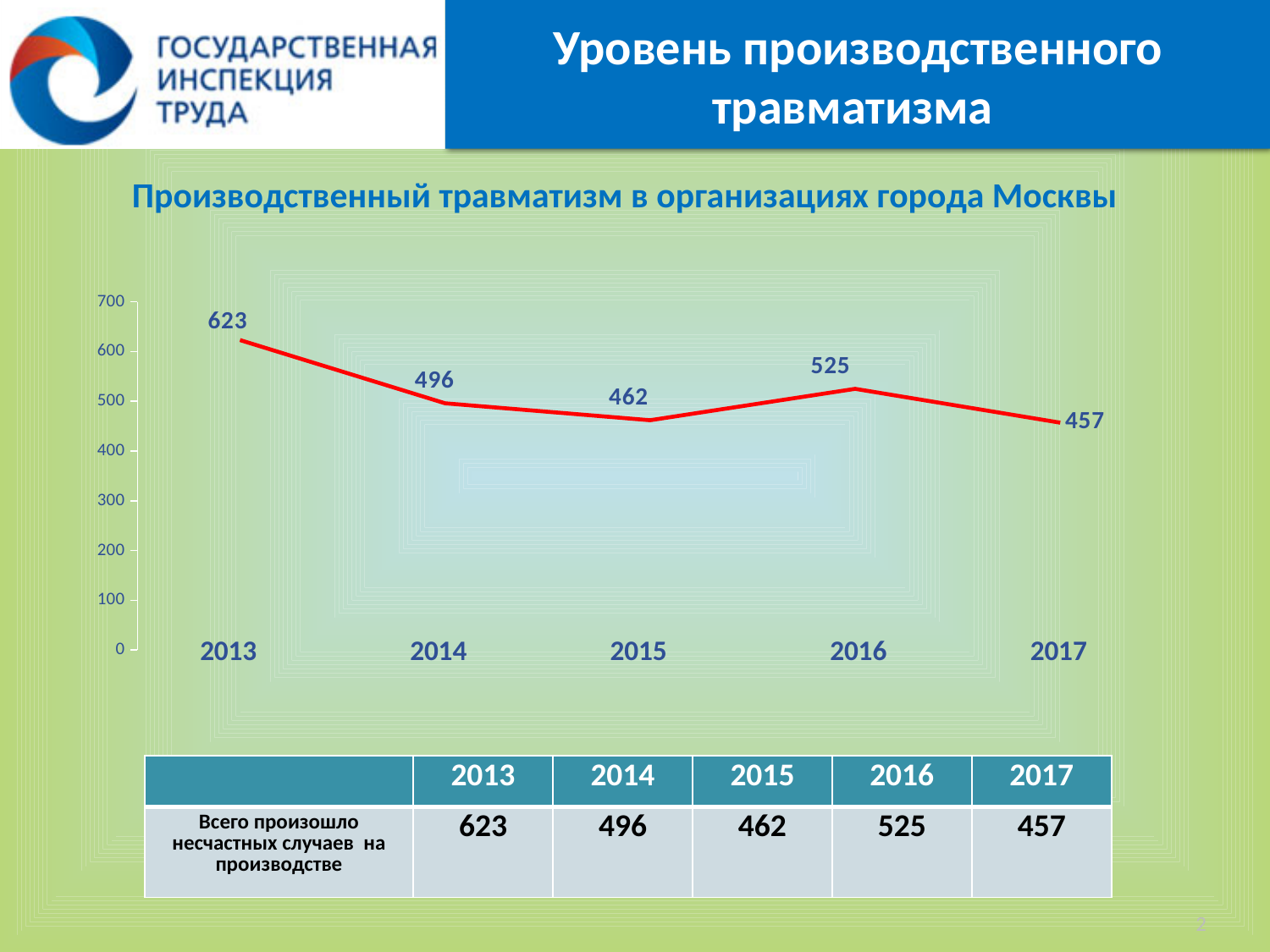
What is the value for 2017? 457 What is the difference between the values for 2016 and 2017? 68 What is the title of the chart? Производственный травматизм в организациях города Москвы What is the value for 2013? 623 What kind of chart is shown? line chart Which year has the highest value? 2013 What is the difference between the values for 2013 and 2014? 127 Which year has the lowest value? 2017 How many years are plotted on the chart? 5 What is the value for 2015? 462 Which is larger, the value for 2014 or the value for 2016? 2016 Is the value for 2016 greater or less than 500? greater